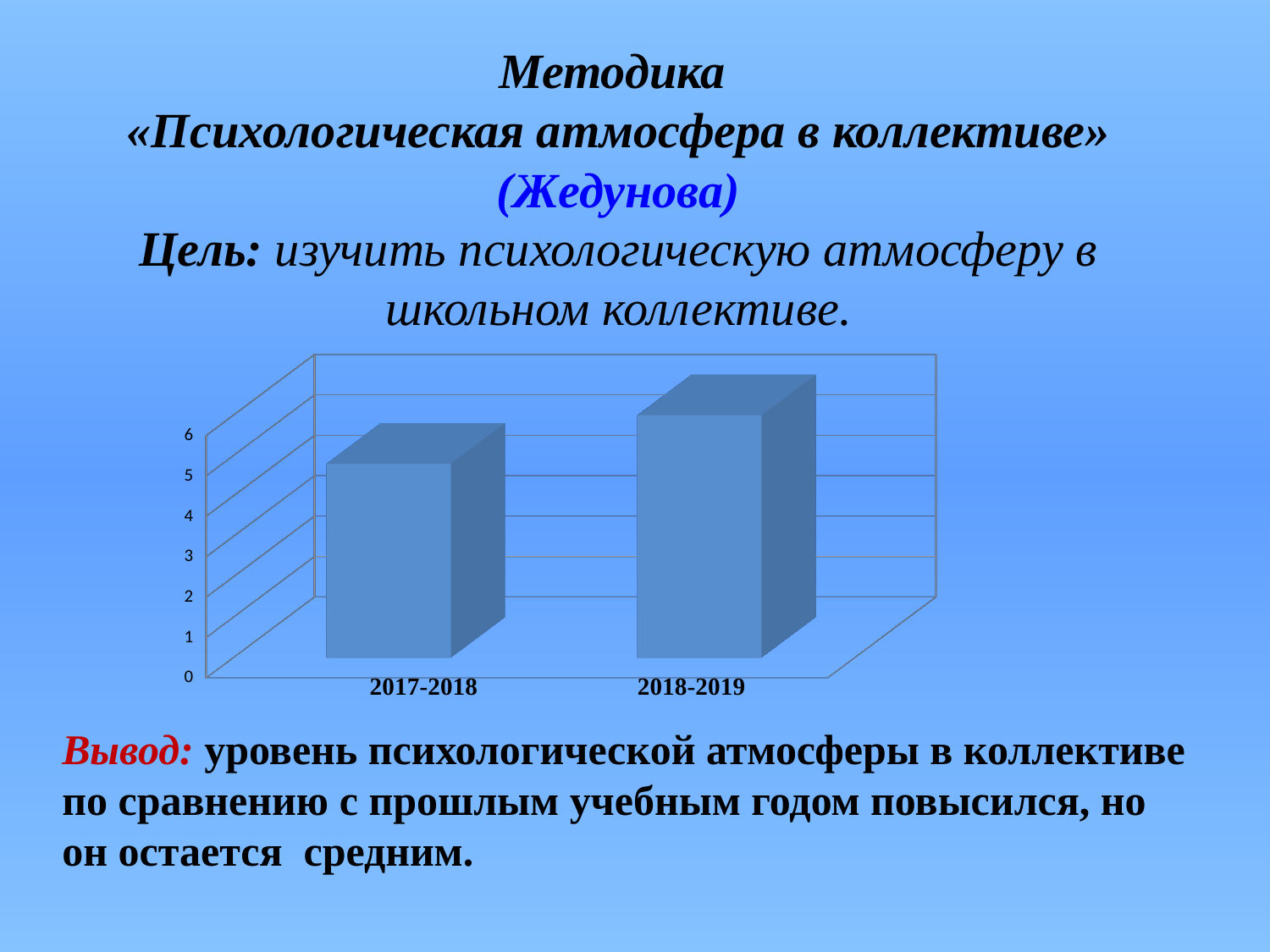
Which category has the lowest bar in the chart? 2017-2018 Is the value for 2018-2019 greater or less than 5? greater Do the values rise or fall from 2017-2018 to 2018-2019? rise Is the value for 2018-2019 greater or less than 3? greater Is the value for 2017-2018 greater or less than 6? less How many categories (bars) does the chart show? 2 Which category has the highest bar in the chart? 2018-2019 What are the two category labels on the horizontal axis of the chart? 2017-2018 and 2018-2019 What is the highest value shown on the vertical axis of the chart? 6 Which is larger, the value for 2017-2018 or the value for 2018-2019? 2018-2019 What kind of chart is shown on the slide? bar chart